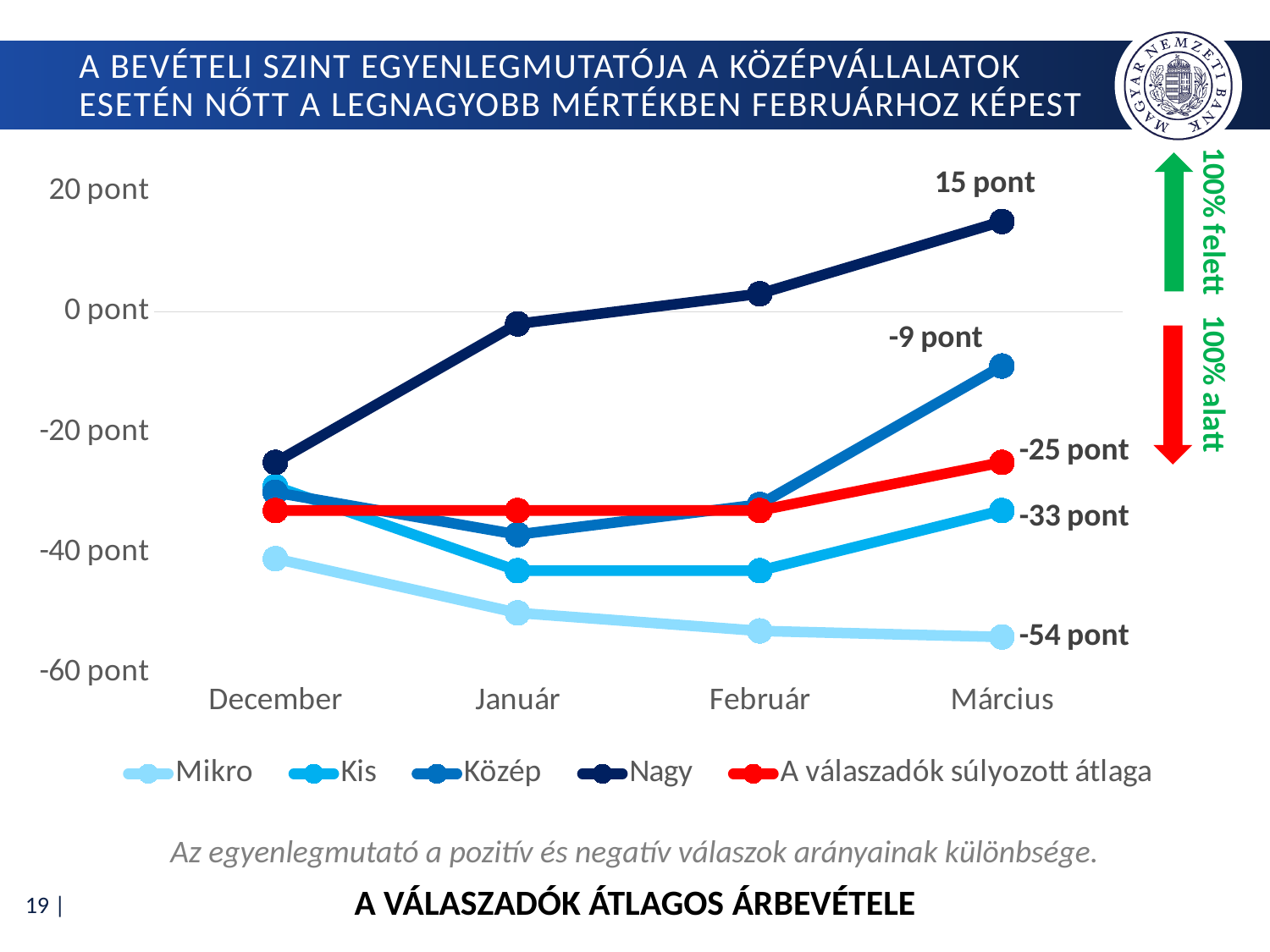
What is the difference between the Nagy and Mikro values in Március? 69 pont What is the value for Mikro in Március? -54 pont What is the value for Nagy in Március? 15 pont Which series has the lowest value in Március? Mikro Is the value for Nagy in December greater or less than -20 pont? less How many series does the legend list? 5 What is the value of 'A válaszadók súlyozott átlaga' in Március? -25 pont In Március, which is larger: the value for Kis or the value for Közép? Közép What kind of chart is shown on the slide? line chart Which series has the highest value in Március? Nagy What is the value for Közép in Március? -9 pont How many months are shown on the x axis? 4